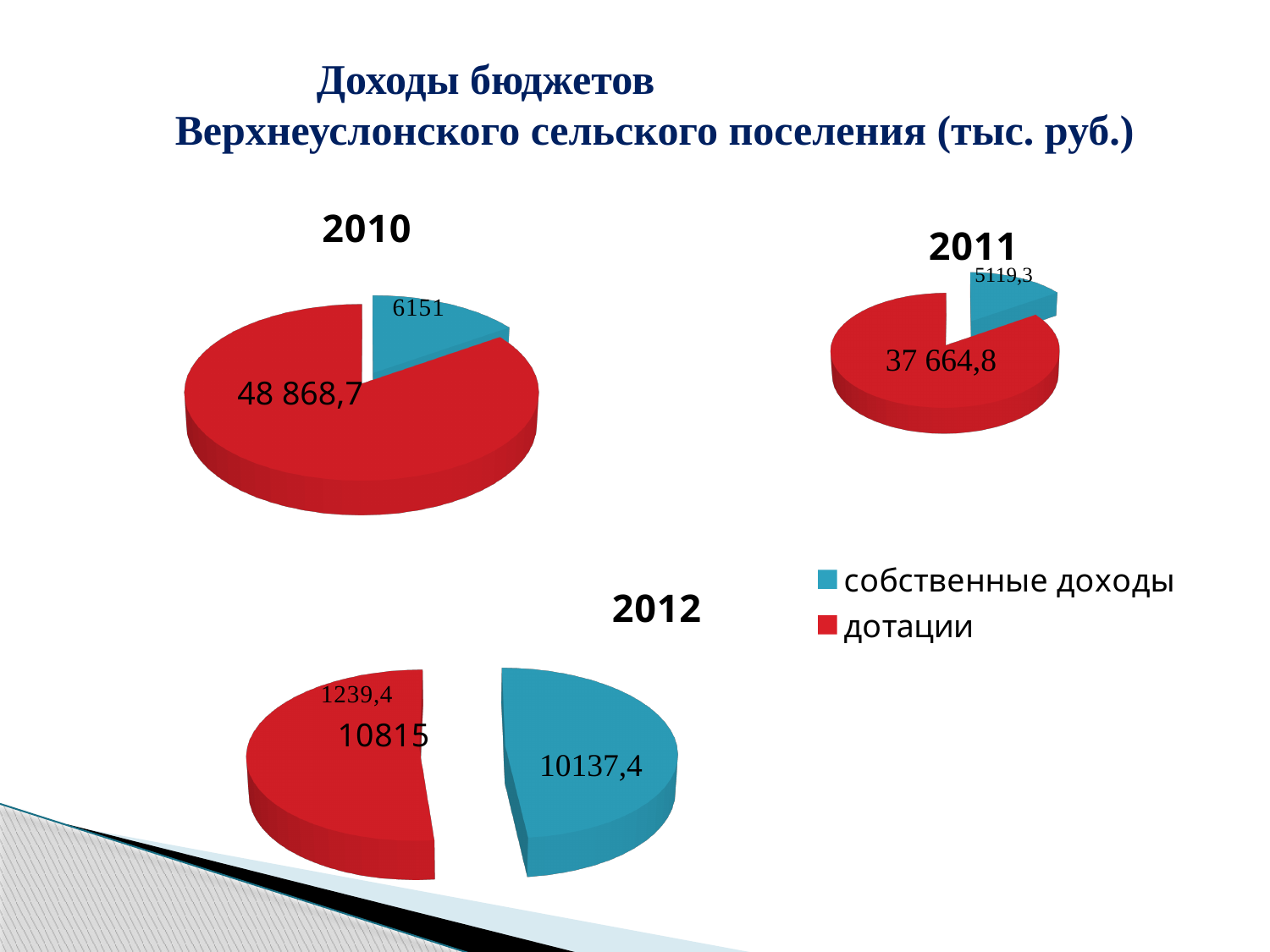
What kind of chart is used for the 2010 data? pie chart In the 2010 pie chart, what is the value for собственные доходы? 6151 How many series does the legend list? 2 In the 2011 pie chart, which category is the smallest? собственные доходы In the 2012 pie chart, what is the value for собственные доходы? 10137,4 In the 2011 pie chart, what is the total of собственные доходы and дотации? 42 784,1 Is the value for собственные доходы larger in the 2010 chart or the 2011 chart? 2010 In the 2010 pie chart, what is the value for дотации? 48 868,7 In the 2010 pie chart, which category is the largest? дотации In the 2011 pie chart, what is the value for дотации? 37 664,8 In the 2010 pie chart, what is the difference between дотации and собственные доходы? 42 717,7 In the 2011 pie chart, what is the value for собственные доходы? 5119,3